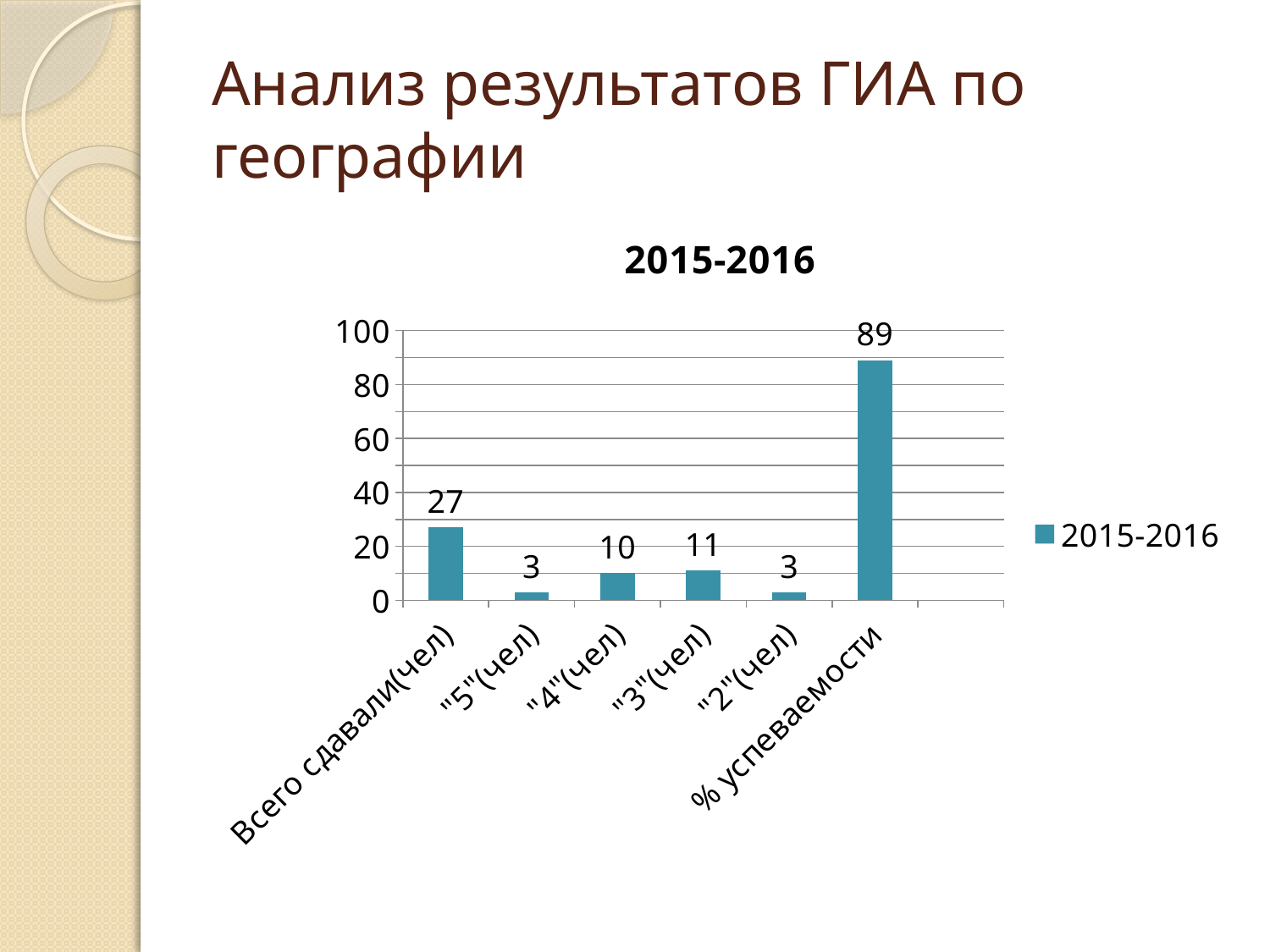
What is the difference between the values for "3"(чел) and "2"(чел)? 8 What is the difference between the values for "Всего сдавали(чел)" and "4"(чел)? 17 Which category has the highest value? % успеваемости Is the value for "% успеваемости" greater or less than 80? greater How many series does the legend list? 1 What is the value for "4"(чел)? 10 What is the value for "% успеваемости"? 89 What is the value for "3"(чел)? 11 Which is larger, the value for "3"(чел) or the value for "4"(чел)? "3"(чел) How many categories are shown on the x axis? 6 What kind of chart is shown on the slide? bar chart What is the value for "Всего сдавали(чел)"? 27